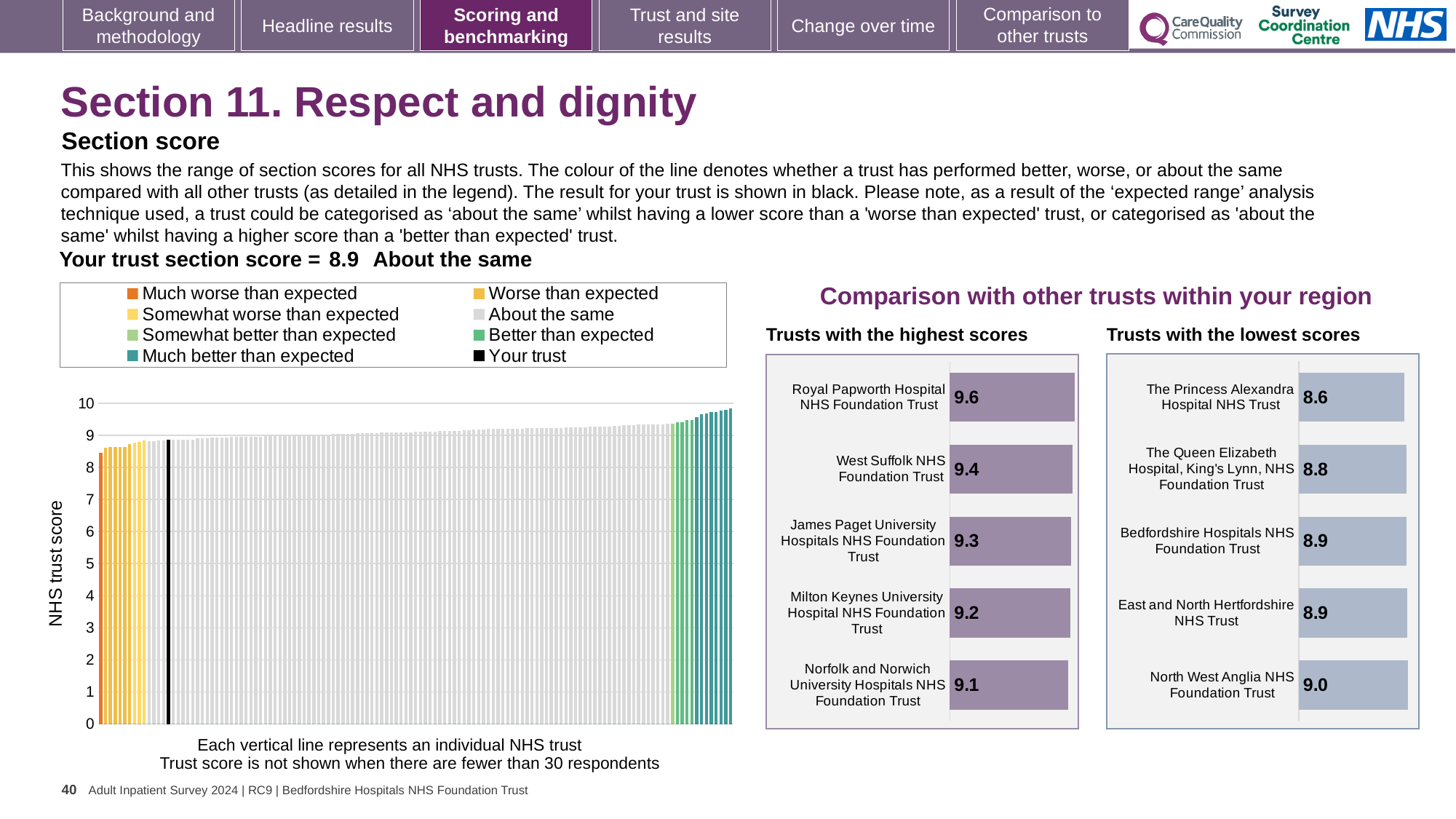
In the 'Trusts with the lowest scores' chart, which has the larger score: The Queen Elizabeth Hospital, King's Lynn, NHS Foundation Trust or Bedfordshire Hospitals NHS Foundation Trust? Bedfordshire Hospitals NHS Foundation Trust In the large chart on the left, do the NHS trust scores rise or fall from left to right along the x axis? rise In the 'Trusts with the lowest scores' chart, what is the difference between the scores of North West Anglia NHS Foundation Trust and The Princess Alexandra Hospital NHS Trust? 0.4 In the 'Trusts with the highest scores' chart, what is the score for Royal Papworth Hospital NHS Foundation Trust? 9.6 In the 'Trusts with the lowest scores' chart, what is the score for The Princess Alexandra Hospital NHS Trust? 8.6 In the 'Trusts with the highest scores' chart, what is the difference between the scores of Royal Papworth Hospital NHS Foundation Trust and West Suffolk NHS Foundation Trust? 0.2 In the 'Trusts with the lowest scores' chart, which trust has the highest score? North West Anglia NHS Foundation Trust In the 'Trusts with the highest scores' chart, which trust has the lowest score? Norfolk and Norwich University Hospitals NHS Foundation Trust What kind of chart is the large chart on the left showing NHS trust scores? bar chart In the large chart on the left, what is the section score for your trust (shown in black)? 8.9 How many entries does the legend above the large chart on the left list? 8 How many trusts are shown in the 'Trusts with the highest scores' chart? 5